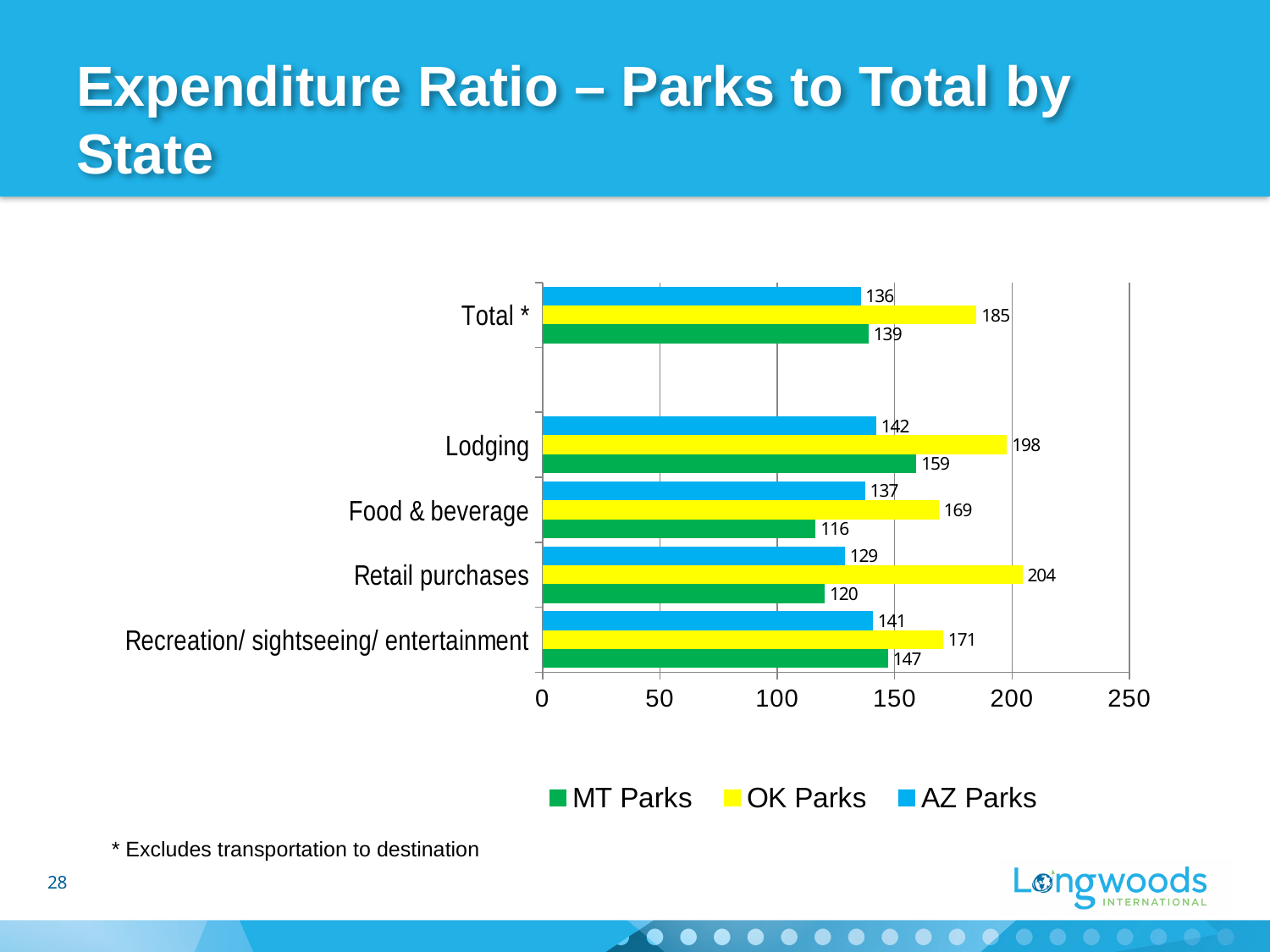
What is the difference between the OK Parks and MT Parks values for Retail purchases? 84 Which category has the lowest MT Parks value? Food & beverage How many series does the legend list? 3 Which is larger for Recreation/ sightseeing/ entertainment: the MT Parks value or the AZ Parks value? MT Parks Is the OK Parks value for Lodging greater or less than 150? greater Which category has the highest OK Parks value? Retail purchases What is the MT Parks value for Food & beverage? 116 What is the OK Parks value for Total *? 185 What kind of chart is shown on the slide? bar chart What is the AZ Parks value for Retail purchases? 129 Which colour represents OK Parks in the chart? yellow What is the OK Parks value for Lodging? 198